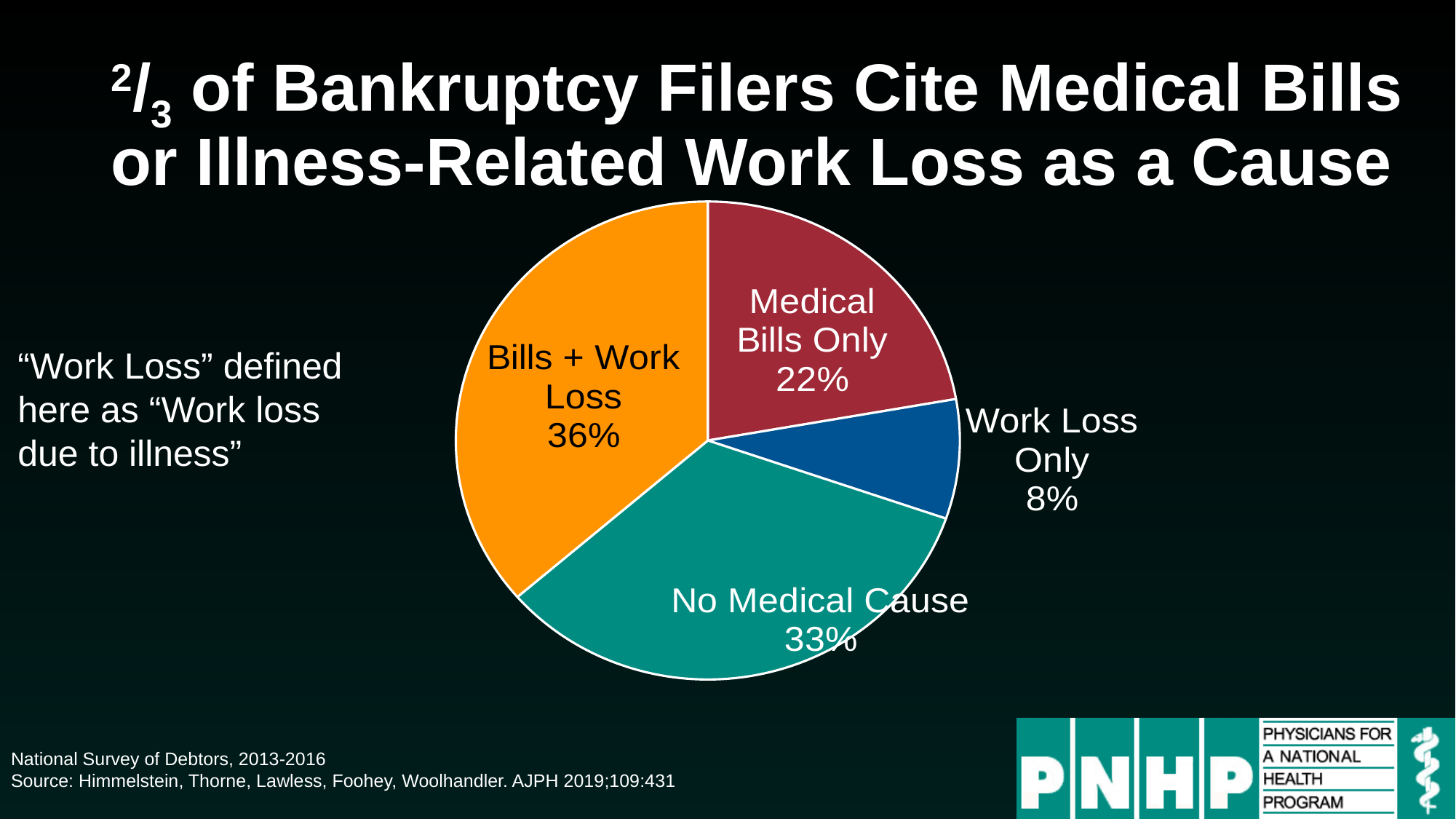
What kind of chart is shown on the slide? Pie chart What percentage of bankruptcy filers cited Bills + Work Loss? 36% What colour is the Bills + Work Loss slice? Orange What percentage of bankruptcy filers cited Medical Bills Only? 22% Which is larger, the share for Medical Bills Only or the share for Work Loss Only? Medical Bills Only Which category has the largest share of the pie? Bills + Work Loss What percentage of bankruptcy filers had No Medical Cause? 33% How many slices does the pie chart have? 4 What percentage of bankruptcy filers cited Work Loss Only? 8% What is the combined percentage of Medical Bills Only and Work Loss Only? 30% Which category has the smallest share of the pie? Work Loss Only What is the difference in percentage points between Bills + Work Loss and Medical Bills Only? 14